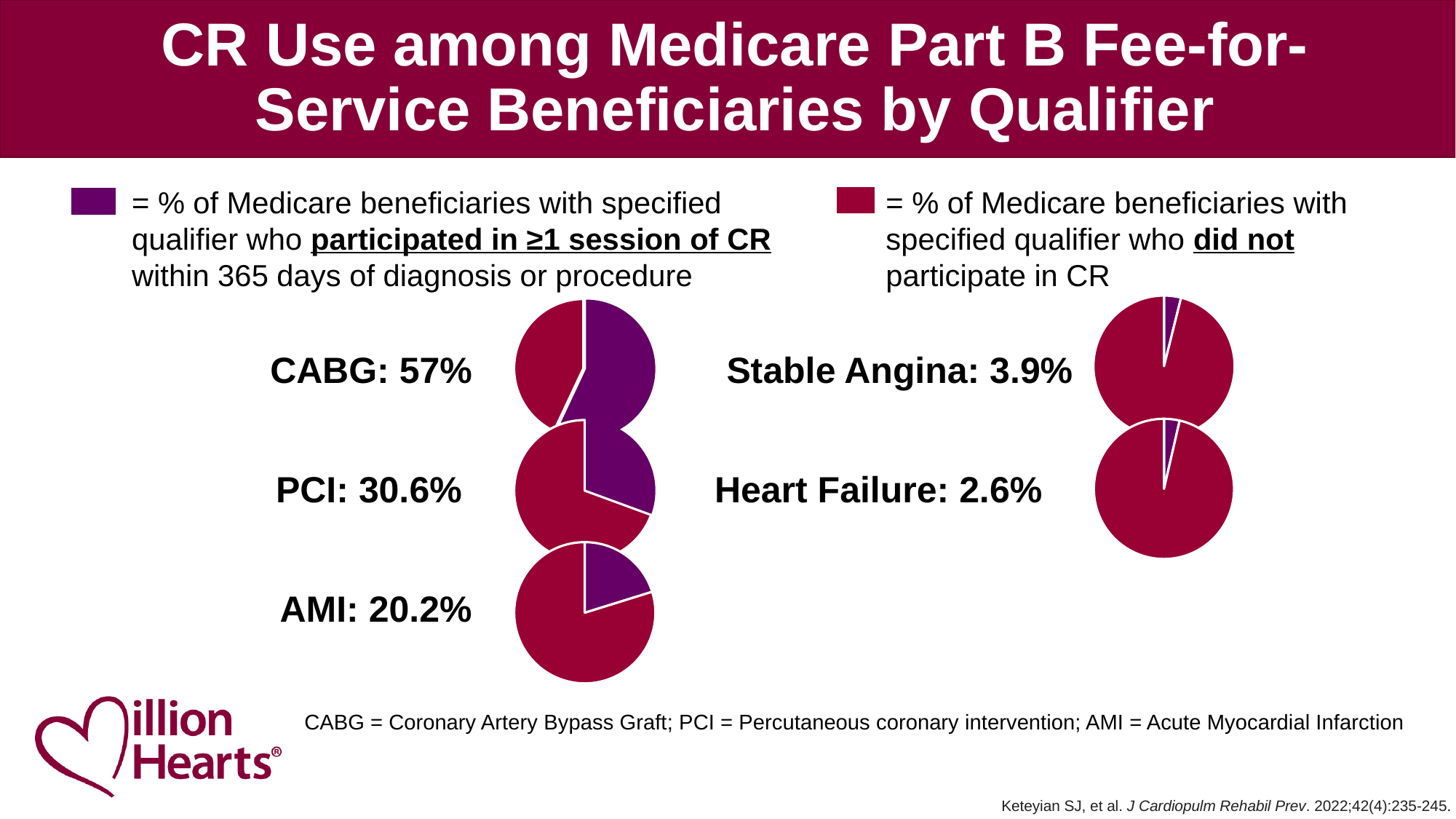
What does the purple colour in the pie charts represent? % of Medicare beneficiaries with specified qualifier who participated in ≥1 session of CR within 365 days of diagnosis or procedure What percentage of Medicare beneficiaries with a CABG qualifier participated in at least one session of CR? 57% What is the difference between the CR participation percentages for Stable Angina and Heart Failure? 1.3% What is the CR participation percentage shown for AMI? 20.2% What is the CR participation percentage shown for Stable Angina? 3.9% Which has a higher CR participation percentage, PCI or AMI? PCI Which qualifier has the highest CR participation percentage? CABG What is the difference between the CR participation percentages for CABG and PCI? 26.4% Which qualifier has the lowest CR participation percentage? Heart Failure How many pie charts are shown on the slide? 5 What is the CR participation percentage shown for PCI? 30.6% What is the CR participation percentage shown for Heart Failure? 2.6%